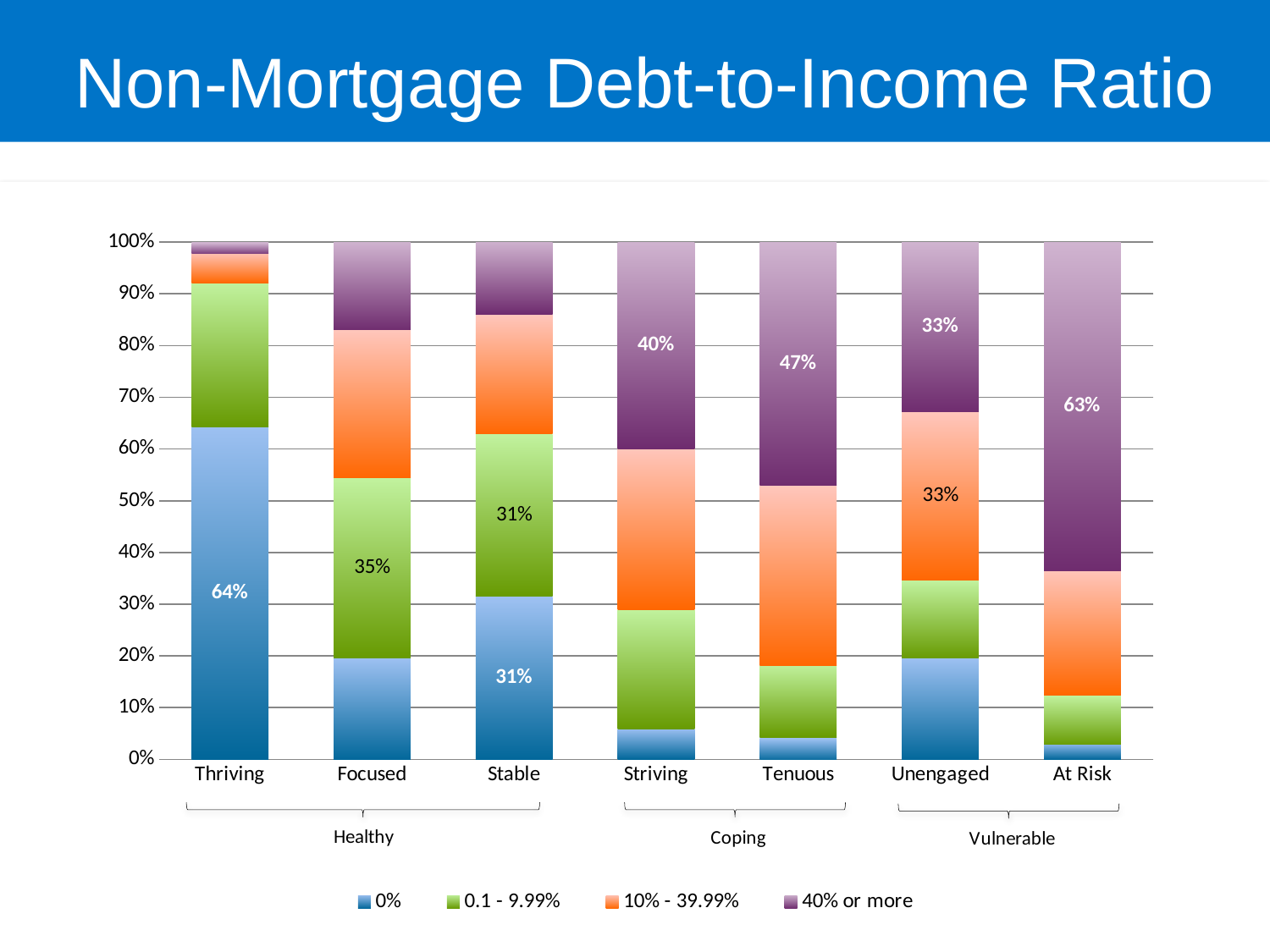
What is the value of the 0% series for Thriving? 64% What is the difference between the 40% or more values for At Risk and Striving? 23% What is the value of the 40% or more series for At Risk? 63% What kind of chart is shown on the slide? Stacked bar chart Is the 0% value for Focused greater or less than 30%? less What is the value of the 10% - 39.99% series for Unengaged? 33% What is the value of the 40% or more series for Tenuous? 47% What is the value of the 0.1 - 9.99% series for Focused? 35% How many series does the legend list? 4 Among the labelled values for the 40% or more series, which category has the highest value? At Risk Which is larger: the 40% or more value for Tenuous or for Striving? Tenuous How many categories are shown on the x axis? 7